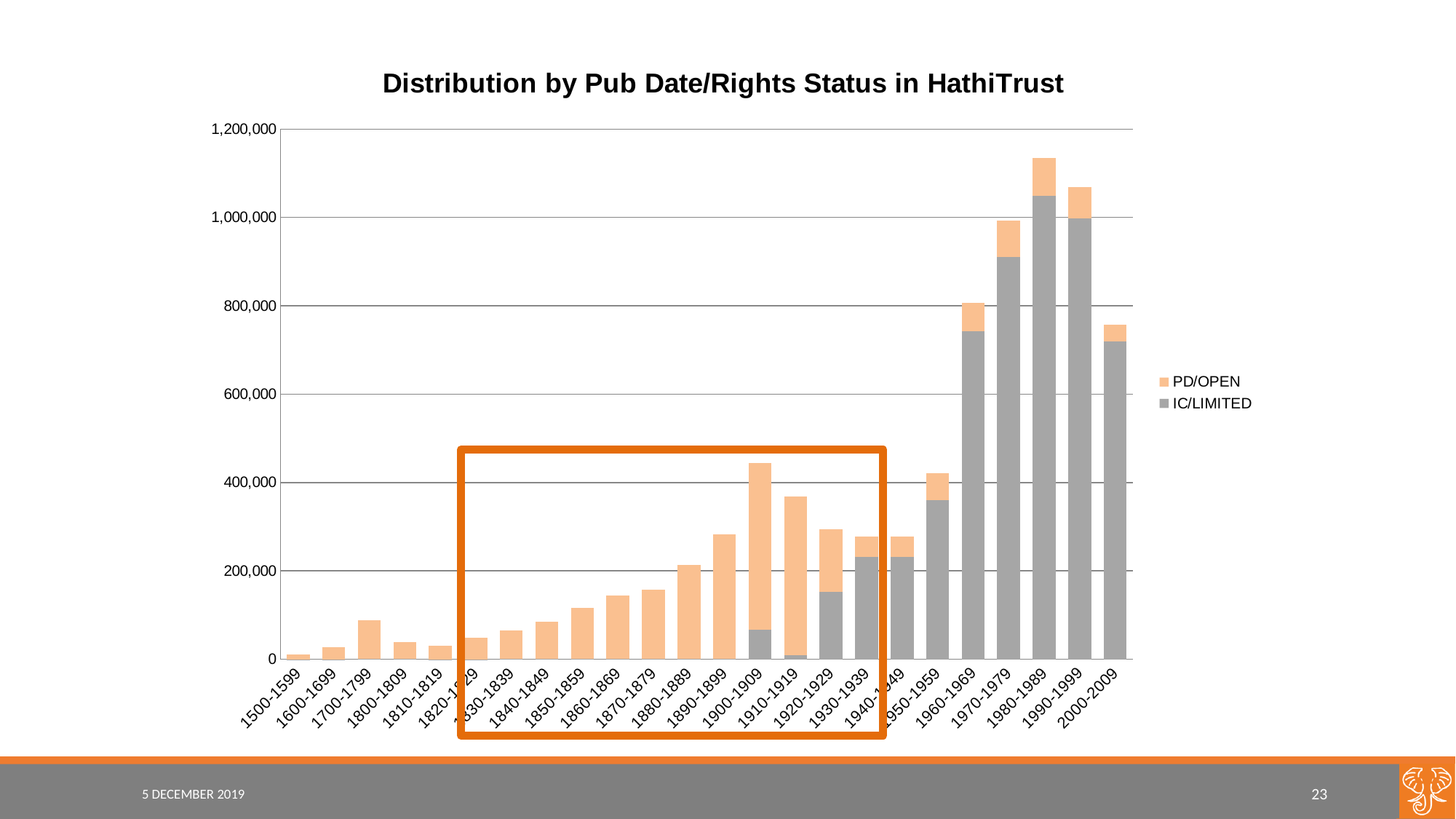
Which series is shown in grey in the legend? IC/LIMITED Which date range has the tallest total bar? 1980-1989 How many series does the legend list? 2 Is the total value for 2000-2009 greater or less than 800,000? less Is the total value for 1900-1909 greater or less than 400,000? greater Is the total value for 1700-1799 greater or less than 200,000? less Which has the larger total bar, 1960-1969 or 1950-1959? 1960-1969 Which has the larger total bar, 1900-1909 or 1910-1919? 1900-1909 What is the title of the chart? Distribution by Pub Date/Rights Status in HathiTrust How many date-range categories are shown on the x axis? 24 What kind of chart is shown on the slide? Stacked bar chart